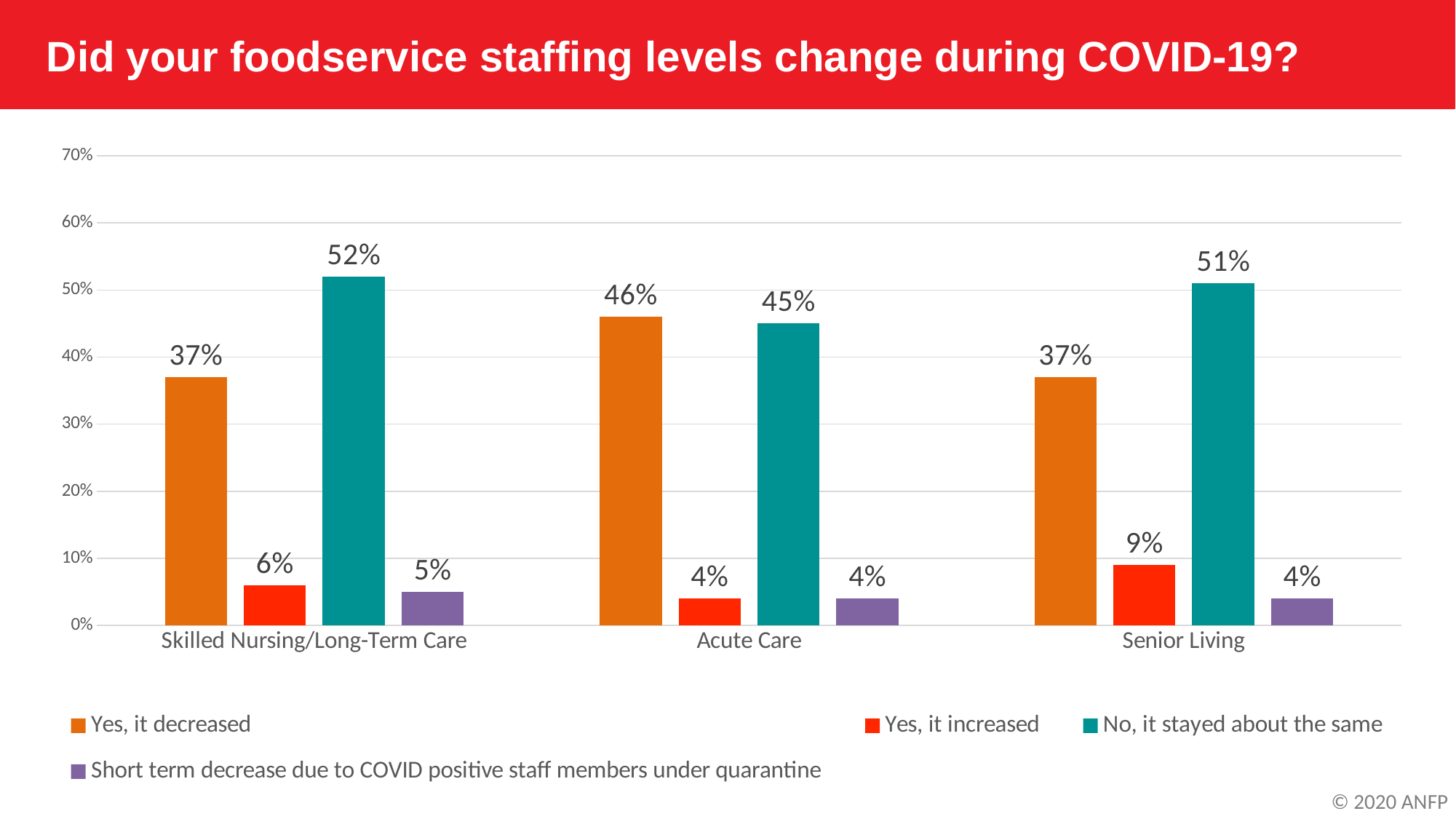
Which category has the highest value for 'Yes, it decreased'? Acute Care What colour represents 'Short term decrease due to COVID positive staff members under quarantine'? Purple What is the value for 'Yes, it decreased' in Acute Care? 46% How many series does the legend list? 4 What is the value for 'Yes, it increased' in Senior Living? 9% Which category has the lowest value for 'Yes, it increased'? Acute Care What kind of chart is shown on the slide? Bar chart How many categories are shown on the x axis? 3 What percentage of Skilled Nursing/Long-Term Care respondents said staffing stayed about the same? 52% In Acute Care, which is larger: 'Yes, it decreased' or 'No, it stayed about the same'? Yes, it decreased What is the difference between 'No, it stayed about the same' and 'Yes, it decreased' in Skilled Nursing/Long-Term Care? 15% Is the value for 'No, it stayed about the same' in Senior Living greater or less than 40%? greater